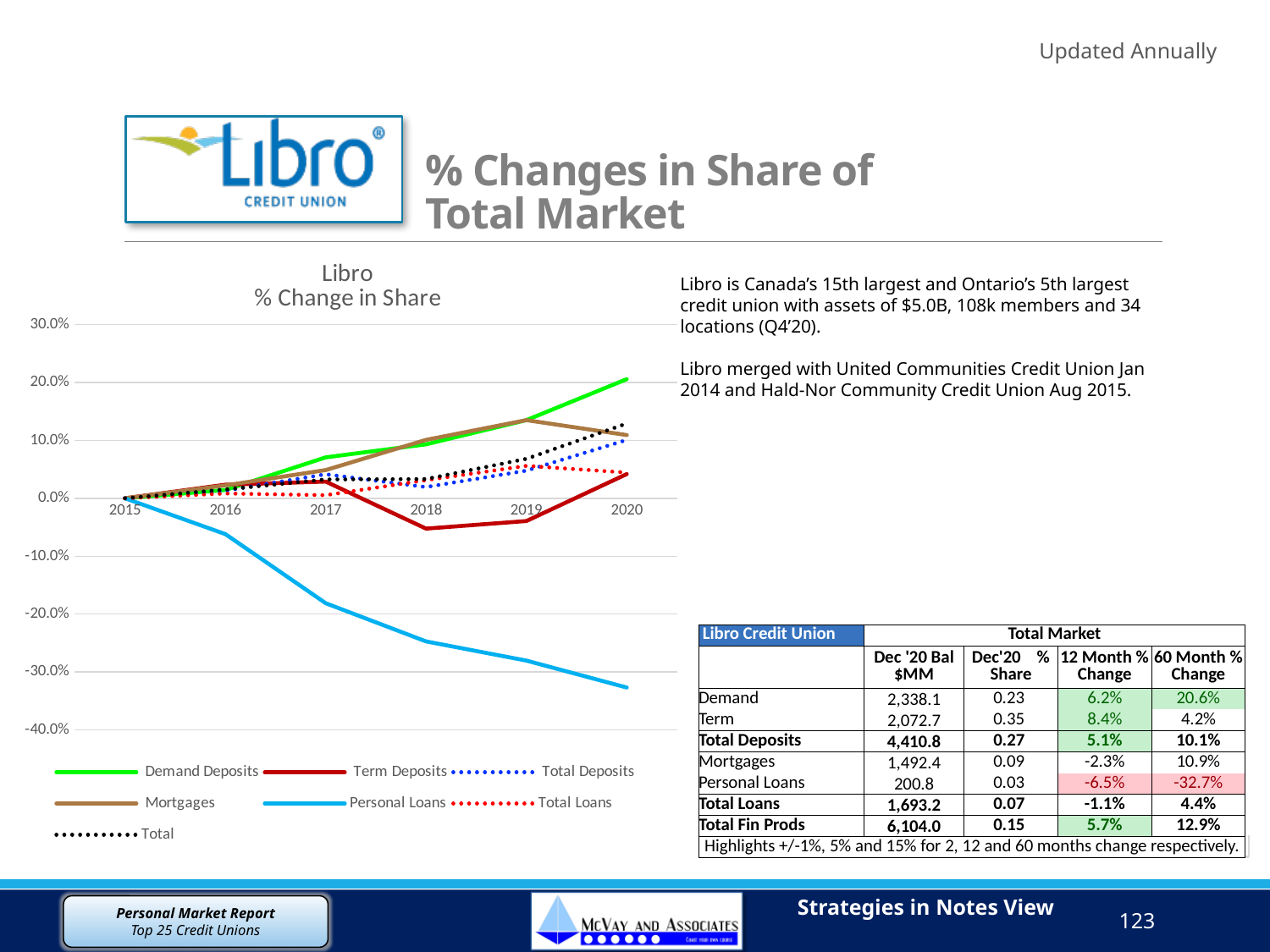
How many series does the legend of the "Libro % Change in Share" chart list? 7 In the "Libro % Change in Share" chart, is the value for Personal Loans in 2018 greater or less than -20.0%? less In the "Libro % Change in Share" chart, which series has the lowest value in 2020? Personal Loans In the "Libro % Change in Share" chart, does the Demand Deposits line rise or fall from 2015 to 2020? rise In the "Libro % Change in Share" chart, which series has the highest value in 2020? Demand Deposits In the "Libro % Change in Share" chart, does the Personal Loans line rise or fall from 2015 to 2020? fall In the "Libro % Change in Share" chart, which is larger in 2019: Mortgages or Term Deposits? Mortgages In the "Libro % Change in Share" chart, what colour is the Personal Loans line? light blue How many years are shown on the x axis of the "Libro % Change in Share" chart? 6 In the "Libro % Change in Share" chart, is the value for Personal Loans in 2020 greater or less than -30.0%? less What kind of chart is the "Libro % Change in Share" chart? line chart In the "Libro % Change in Share" chart, is the value for Demand Deposits in 2020 greater or less than 10.0%? greater